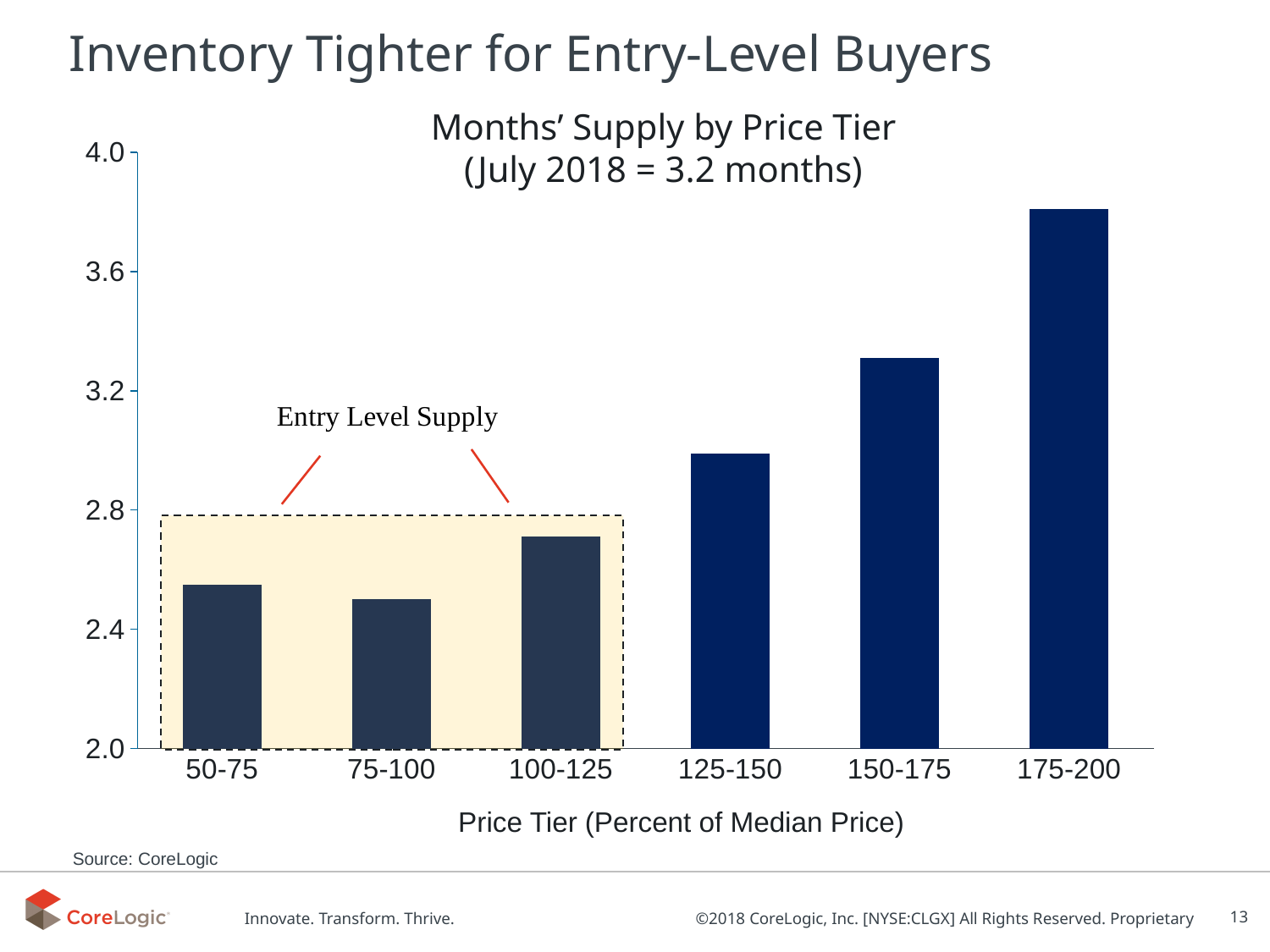
Is the months' supply for the 125-150 price tier greater or less than 3.2? less Which has a larger months' supply, the 50-75 tier or the 100-125 tier? 100-125 Is the months' supply for the 175-200 price tier greater or less than 3.6? greater Is the months' supply for the 150-175 price tier greater or less than 3.2? greater Do the months' supply values generally rise or fall as the price tier increases from left to right? rise Which price tier has the highest months' supply? 175-200 Which price tiers are grouped under the 'Entry Level Supply' annotation on the chart? 50-75, 75-100 and 100-125 What kind of chart is shown on the slide? bar chart How many price tiers are shown on the x axis of the chart? 6 Which has a larger months' supply, the 150-175 tier or the 175-200 tier? 175-200